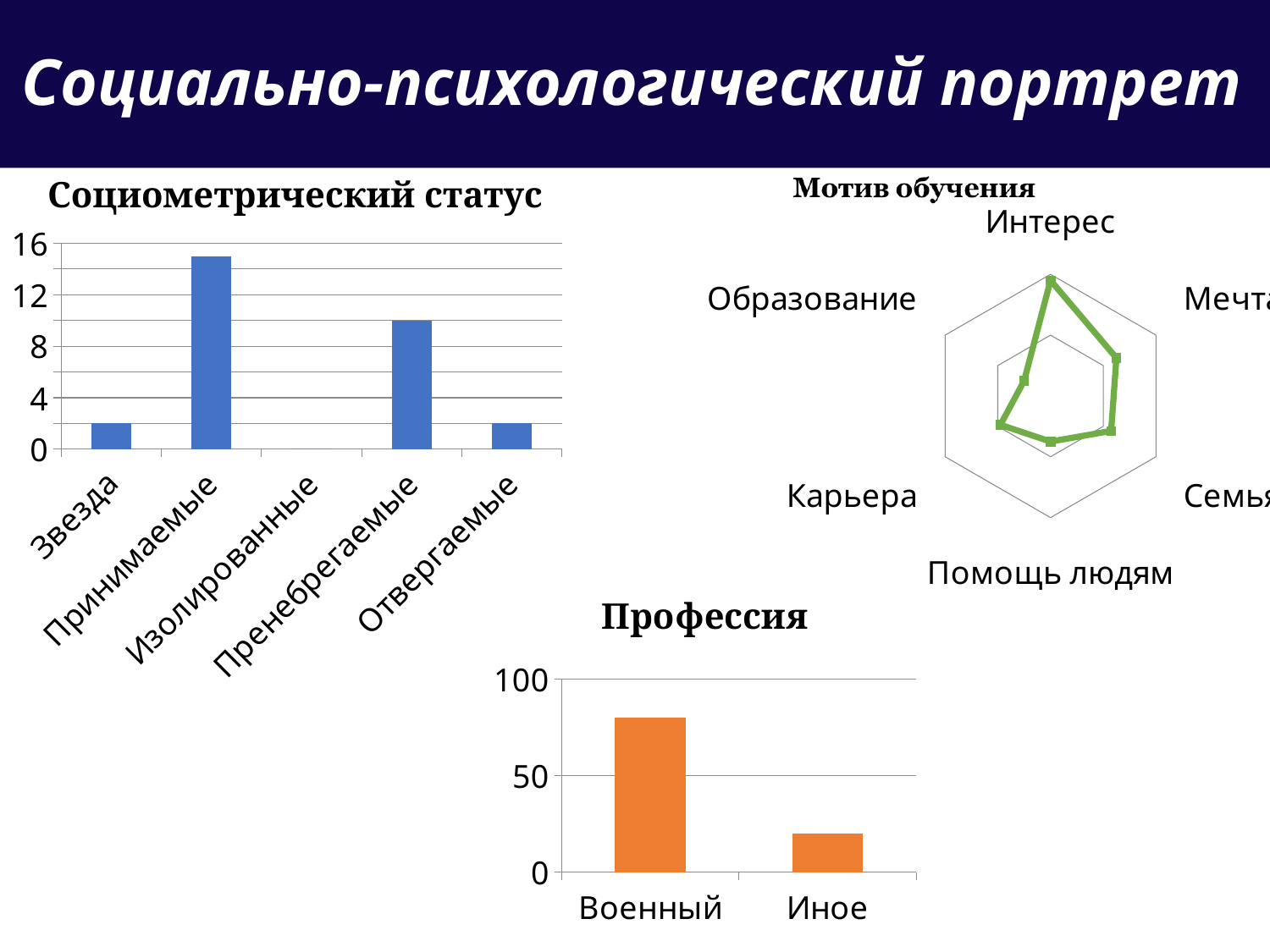
What kind of chart is the "Социометрический статус" chart? bar chart In the "Мотив обучения" chart, which category has the highest value? Интерес In the "Социометрический статус" chart, is the value for Принимаемые greater or less than 12? greater In the "Профессия" chart, is the value for Иное greater or less than 50? less In the "Социометрический статус" chart, which is larger: Принимаемые or Пренебрегаемые? Принимаемые In the "Социометрический статус" chart, which category has the lowest value? Изолированные In the "Профессия" chart, is the value for Военный greater or less than 50? greater How many categories are shown in the "Мотив обучения" chart? 6 How many categories are shown in the "Социометрический статус" chart? 5 In the "Социометрический статус" chart, which category has the highest value? Принимаемые In the "Профессия" chart, which category has the highest value? Военный